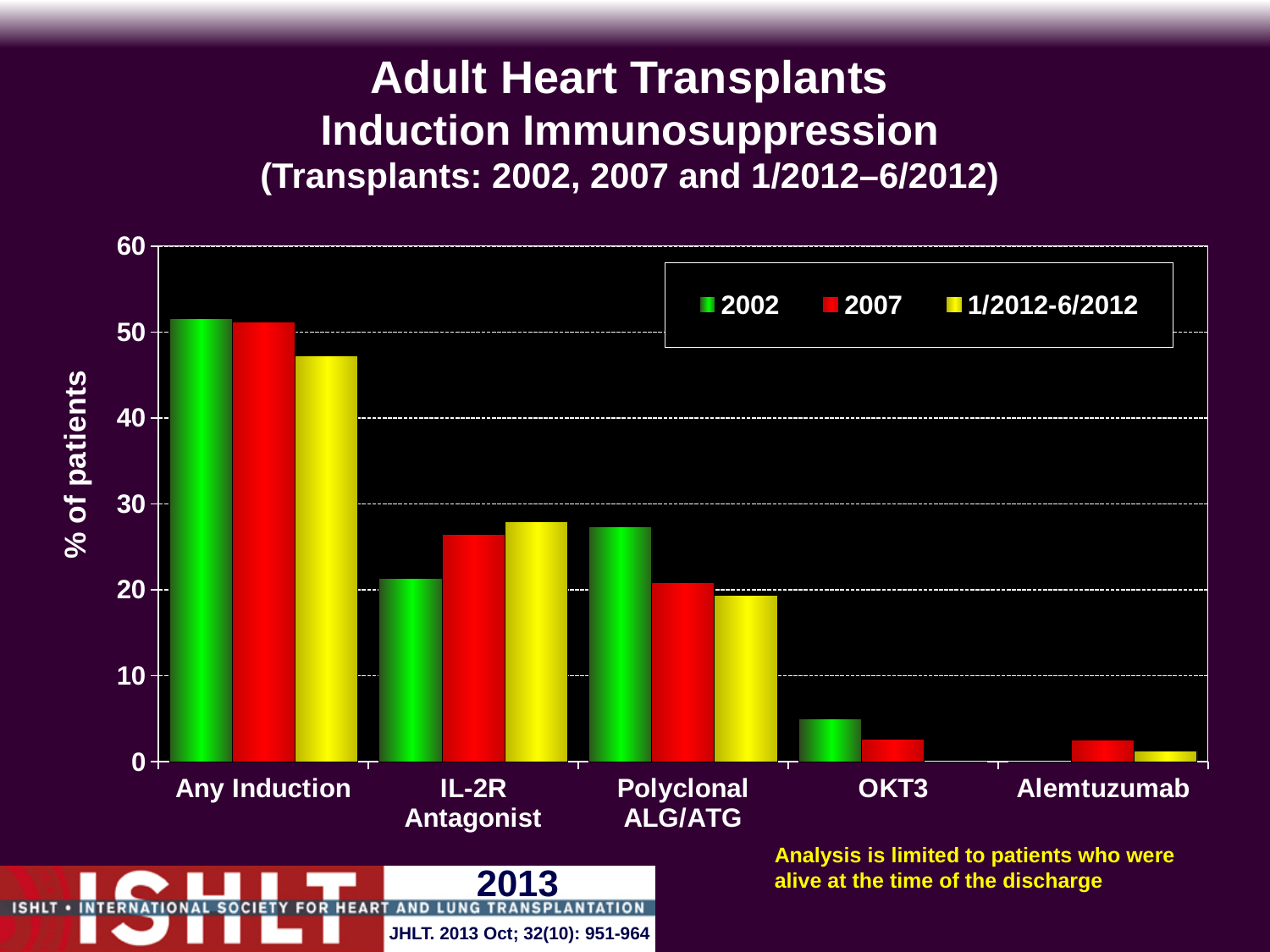
For Polyclonal ALG/ATG, which is larger: the 2002 value or the 2007 value? 2002 Is the 1/2012-6/2012 value for Any Induction greater or less than 40? greater Is the 2007 value for IL-2R Antagonist greater or less than 20? greater For IL-2R Antagonist, which is larger: the 2002 value or the 1/2012-6/2012 value? 1/2012-6/2012 What is the label on the y axis? % of patients How many series does the legend list? 3 Is the 2002 value for Any Induction greater or less than 50? greater How many induction categories are shown on the x axis? 5 What kind of chart is shown on the slide? bar chart Which category has the highest value for the 2002 series? Any Induction For Polyclonal ALG/ATG, do the values rise or fall from 2002 to 2007 to 1/2012-6/2012? fall